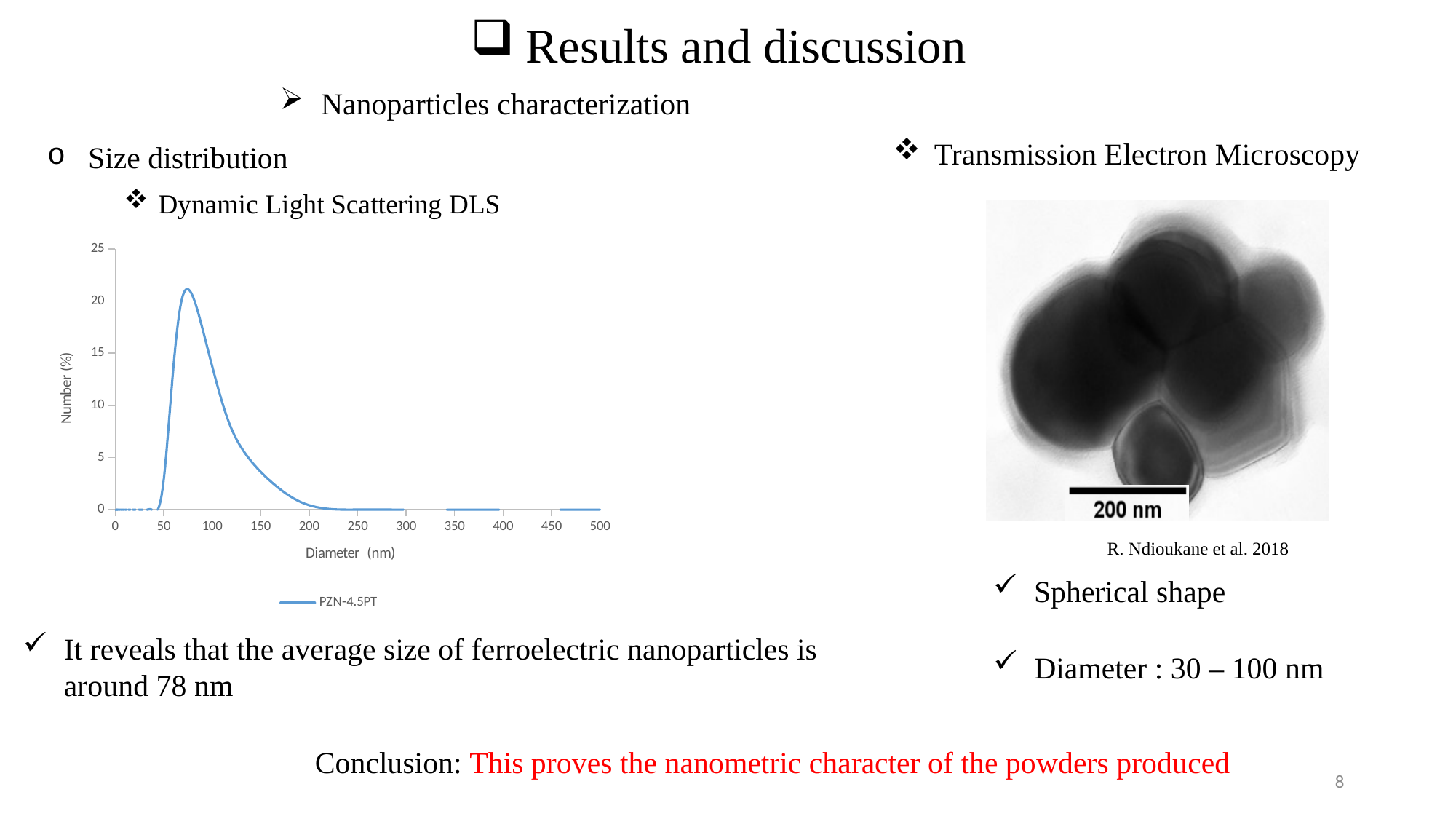
Is the value of the PZN-4.5PT curve at a diameter of 100 nm greater or less than 10? greater Is the value of the PZN-4.5PT curve at a diameter of 200 nm greater or less than 5? less What is the name of the series shown in the chart legend? PZN-4.5PT What is the highest value shown on the x axis of the chart? 500 How many series does the chart legend list? 1 Between which two x-axis tick values does the peak of the PZN-4.5PT curve lie? 50 and 100 Do the values of the PZN-4.5PT curve rise or fall as the diameter increases from 100 nm to 200 nm? fall What is the label of the x axis of the chart? Diameter (nm) What kind of chart is shown on the slide? line chart Do the values of the PZN-4.5PT curve rise or fall as the diameter increases from 50 nm to 75 nm? rise